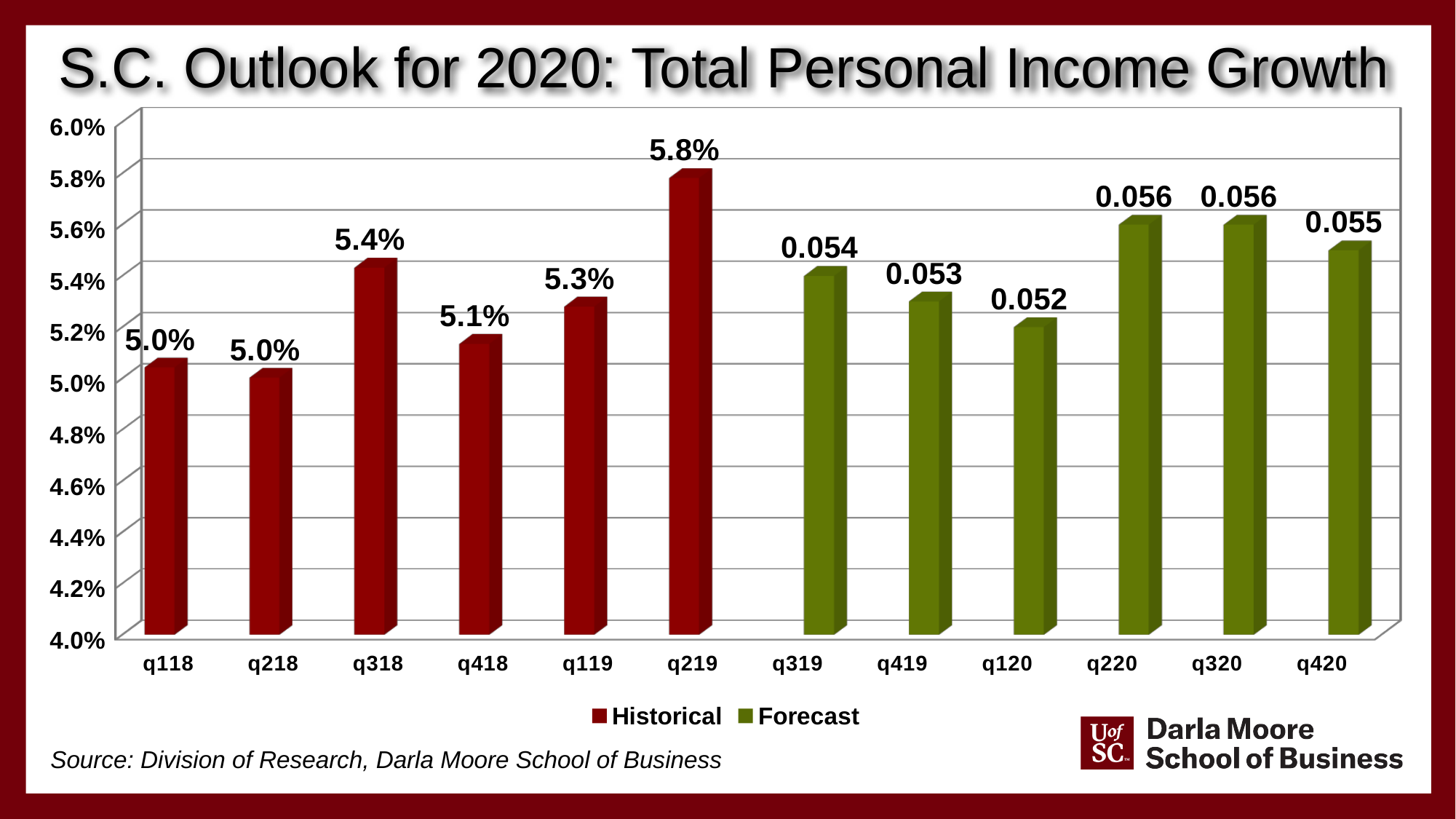
Which is larger, the value for q219 or the value for q318? q219 What is the difference between the values for q318 and q418? 0.3 percentage points How many quarters are shown on the x axis? 12 Which series is shown in green according to the legend? Forecast What is the value shown for q219? 5.8% What kind of chart is shown on the slide? bar chart Is the value for q120 greater or less than 5.0%? greater How many series does the legend list? 2 What is the value shown for q418? 5.1% What is the data label shown for q220? 0.056 What is the data label shown for q120? 0.052 Which quarter has the highest value in the chart? q219